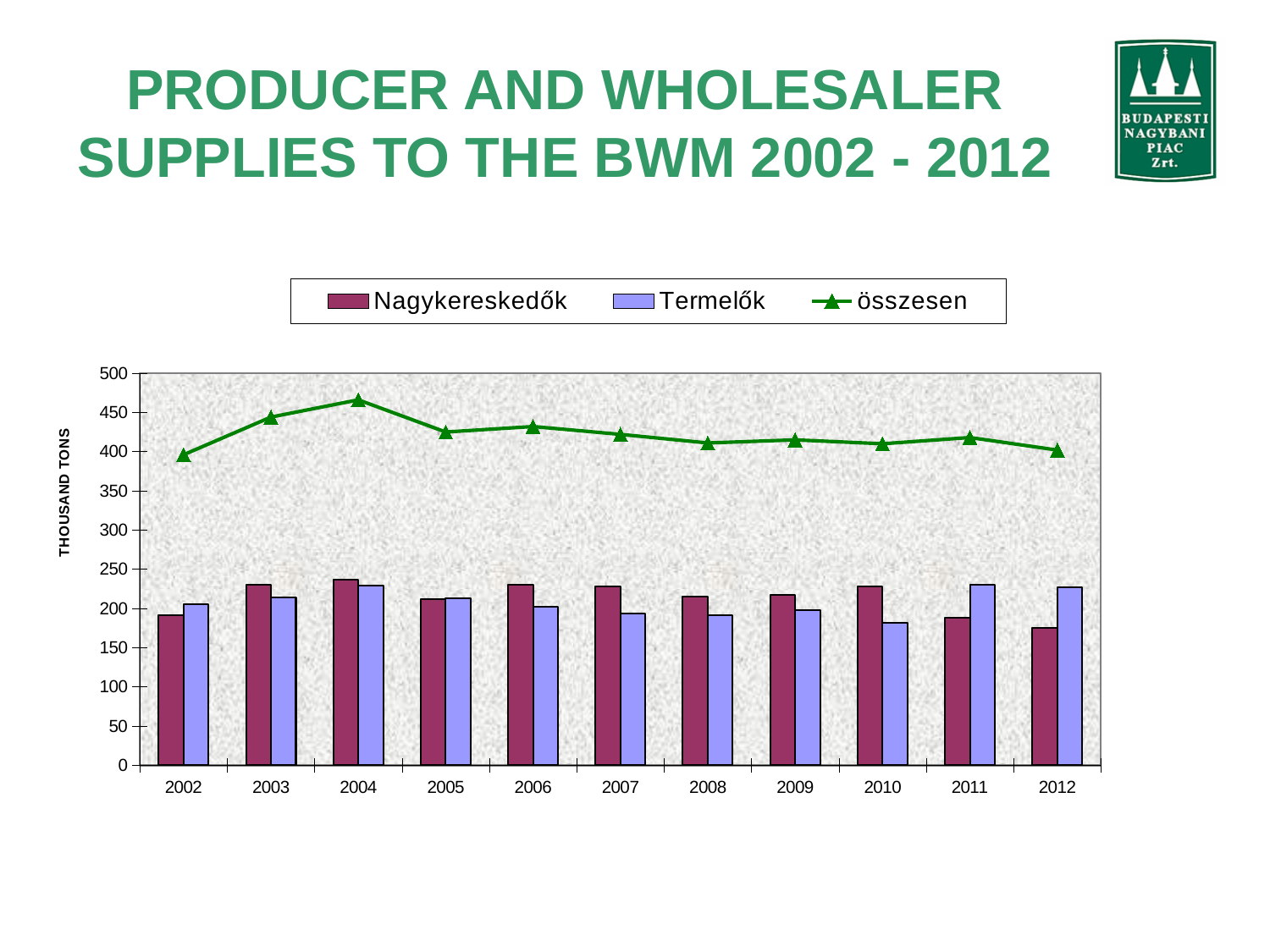
In which year is the Nagykereskedők bar the lowest? 2012 In 2010, which is larger: Nagykereskedők or Termelők? Nagykereskedők In which year is the Termelők bar the lowest? 2010 What kind of chart is this? Combined bar and line chart What is the label on the vertical axis? THOUSAND TONS How many years are shown on the x axis? 11 In 2012, which is larger: Nagykereskedők or Termelők? Termelők Is the összesen value for 2004 greater or less than 450? greater In which year does the összesen line reach its highest value? 2004 Is the Nagykereskedők value for 2012 greater or less than 200? less How many series does the legend list? 3